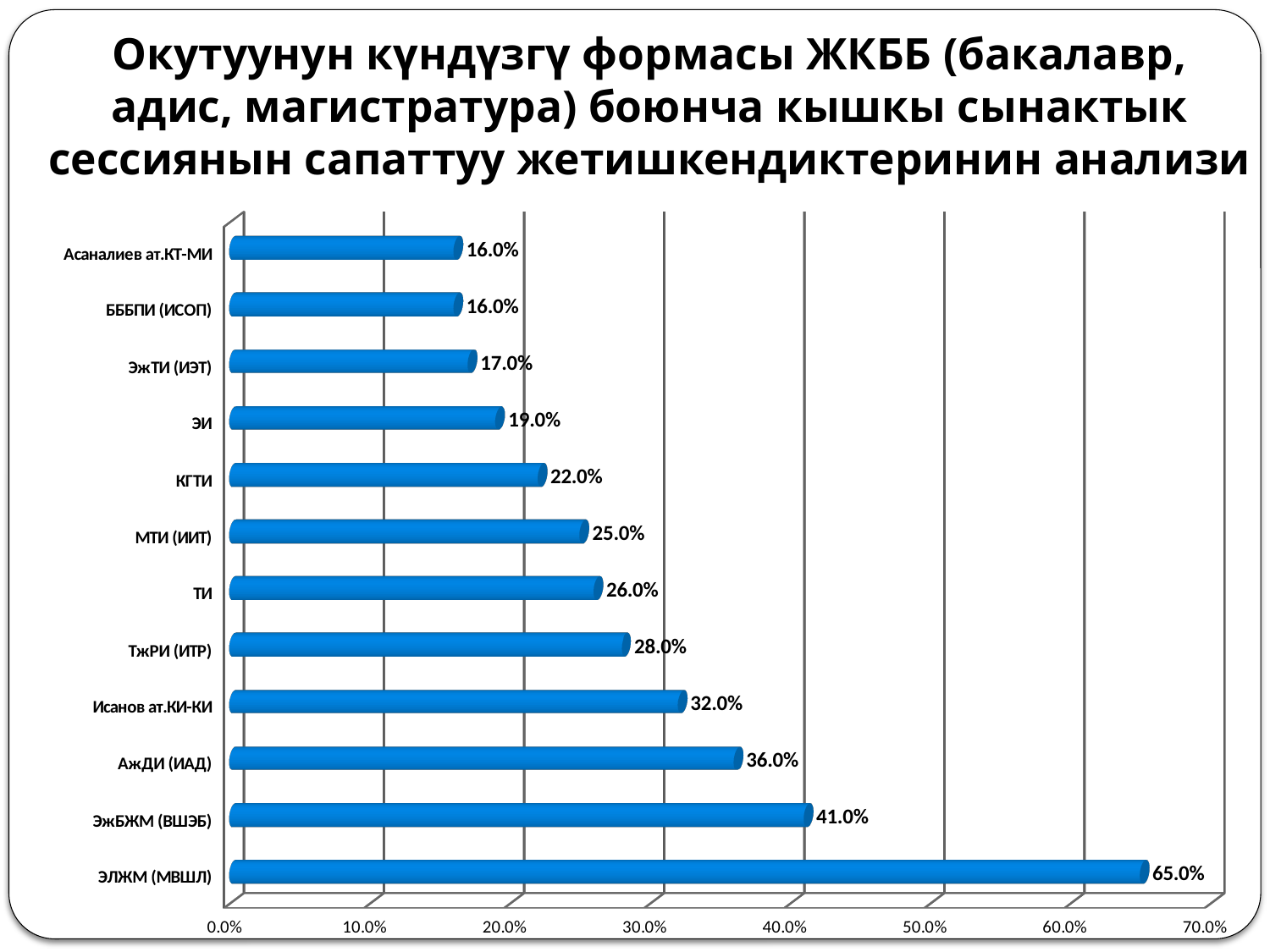
Is the value for ТжРИ (ИТР) greater or less than 30.0%? less What is the difference between the values for ЭжБЖМ (ВШЭБ) and АжДИ (ИАД)? 5.0% What is the lowest value shown on the chart? 16.0% What is the maximum value shown on the horizontal axis? 70.0% What kind of chart is shown on the slide? bar chart What is the value for Исанов ат.КИ-КИ? 32.0% Which category has the highest value? ЭЛЖМ (МВШЛ) Which is larger, the value for ТИ or the value for ЭИ? ТИ What is the value for ЭЛЖМ (МВШЛ)? 65.0% What is the value for КГТИ? 22.0% How many categories are shown on the chart? 12 What is the difference between the values for ЭЛЖМ (МВШЛ) and Асаналиев ат.КТ-МИ? 49.0%